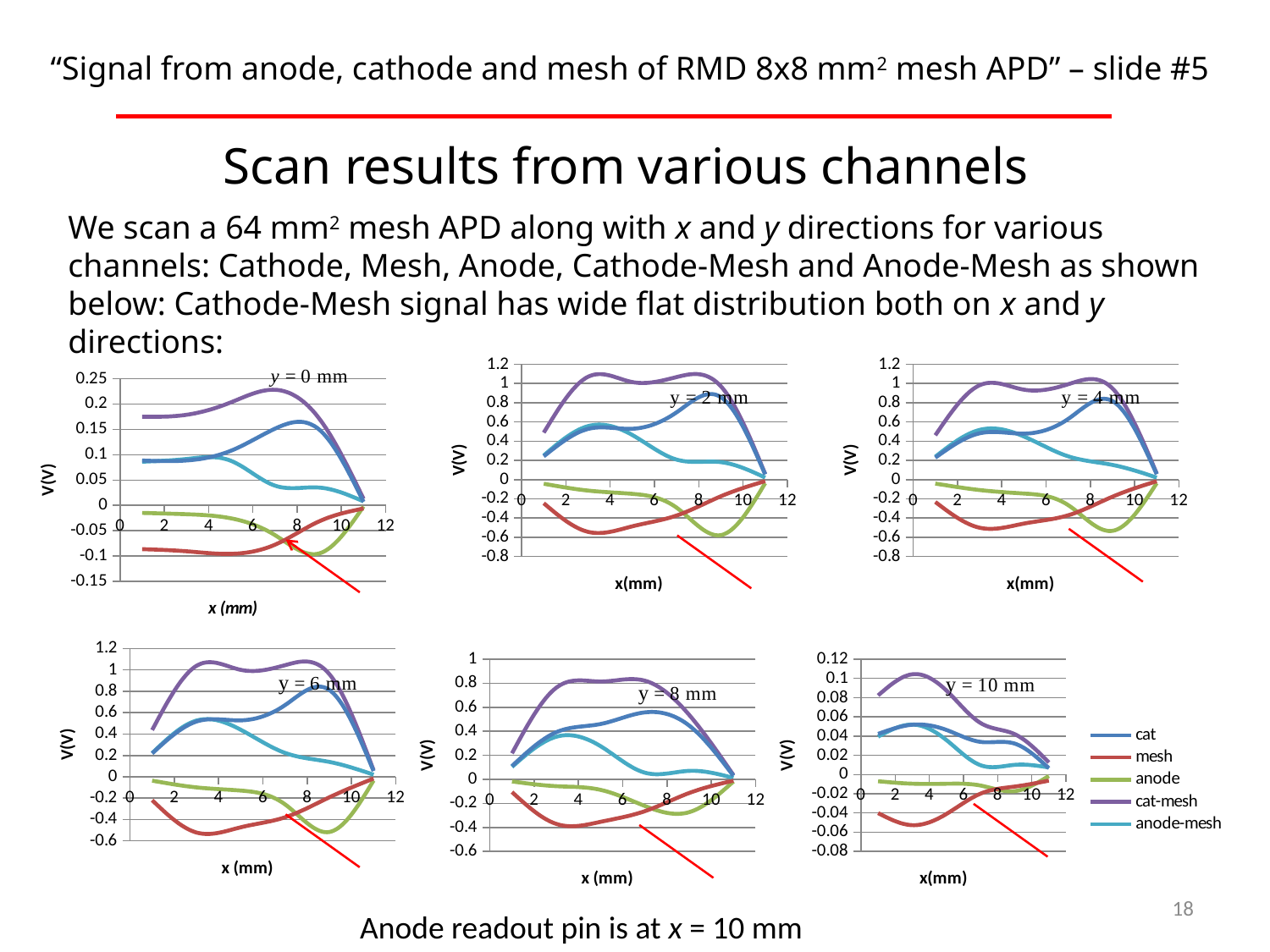
What kind of chart is the y = 0 mm chart? line chart In the y = 2 mm chart, is the peak value of the cat-mesh series greater or less than 1? greater In the y = 8 mm chart, is the peak value of the cat-mesh series greater or less than 1? less In the y = 10 mm chart, is the peak value of the cat-mesh series greater or less than 0.08? greater In the y = 0 mm chart, which series has the highest values? cat-mesh In the y = 10 mm chart, does the cat-mesh series rise or fall from x = 4 mm to x = 11 mm? fall What are the series names listed in the legend? cat, mesh, anode, cat-mesh, anode-mesh In the y = 0 mm chart, at x = 8 mm, which is larger: cat-mesh or cat? cat-mesh How many series does the legend list? 5 In the y = 8 mm chart, which series reaches the lowest value? mesh How many charts are shown on the slide? 6